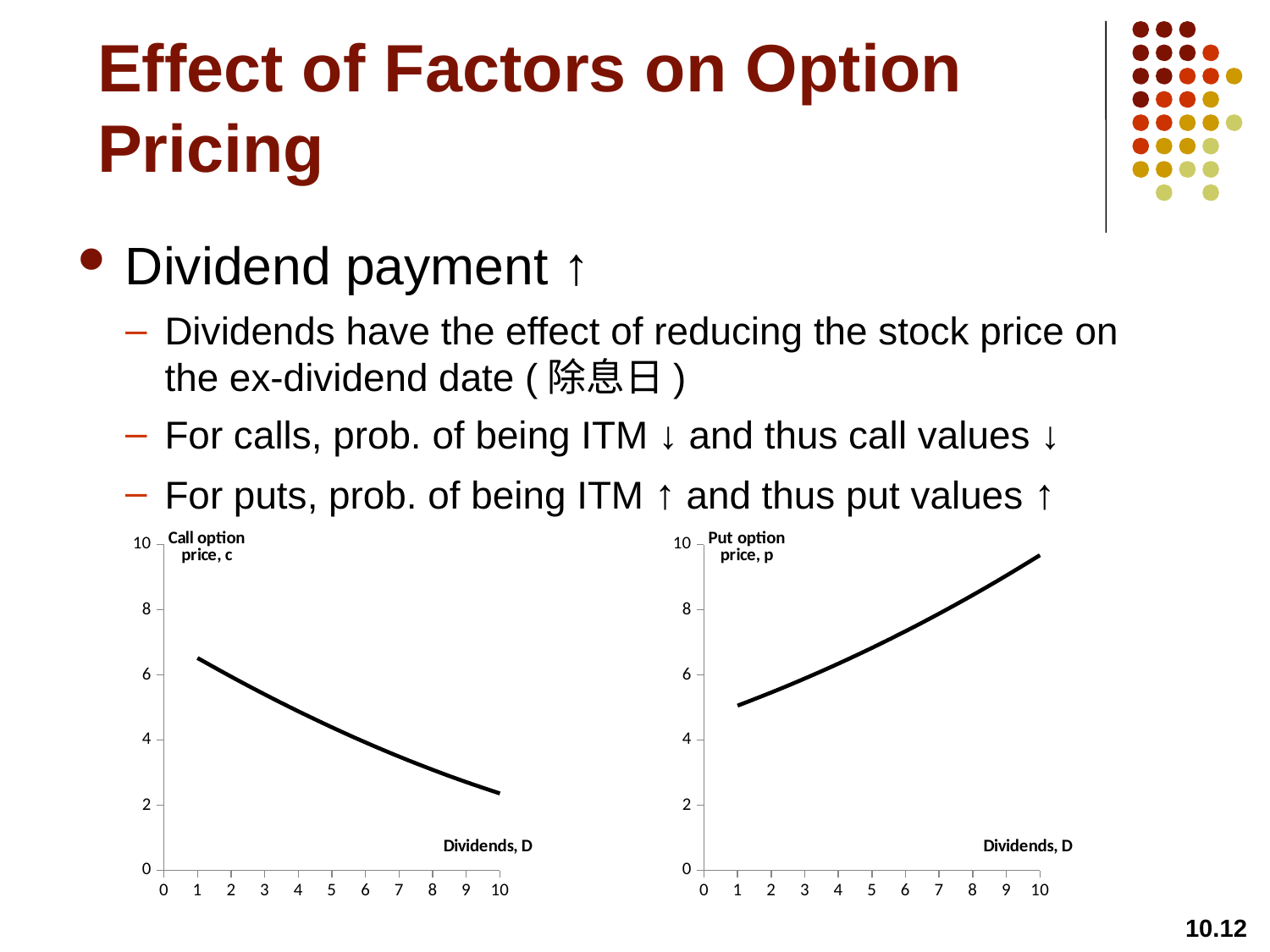
What is the highest tick value shown on the vertical axis of the right chart (Put option price, p)? 10 What kind of chart is the right chart, labelled "Put option price, p"? line chart What is the label of the horizontal axis on the left chart (Call option price, c)? Dividends, D In the left chart (Call option price, c), is the call option price at D = 1 greater or less than 6? greater In the right chart (Put option price, p), is the put option price at D = 1 greater or less than 6? less In the right chart (Put option price, p), does the put option price rise or fall as Dividends, D increases? rise In the left chart (Call option price, c), which is larger: the call option price at D = 1 or at D = 10? D = 1 In the right chart (Put option price, p), is the put option price at D = 10 greater or less than 8? greater What kind of chart is the left chart, labelled "Call option price, c"? line chart In the left chart (Call option price, c), does the call option price rise or fall as Dividends, D increases? fall In the right chart (Put option price, p), at which value of Dividends, D is the put option price highest? 10